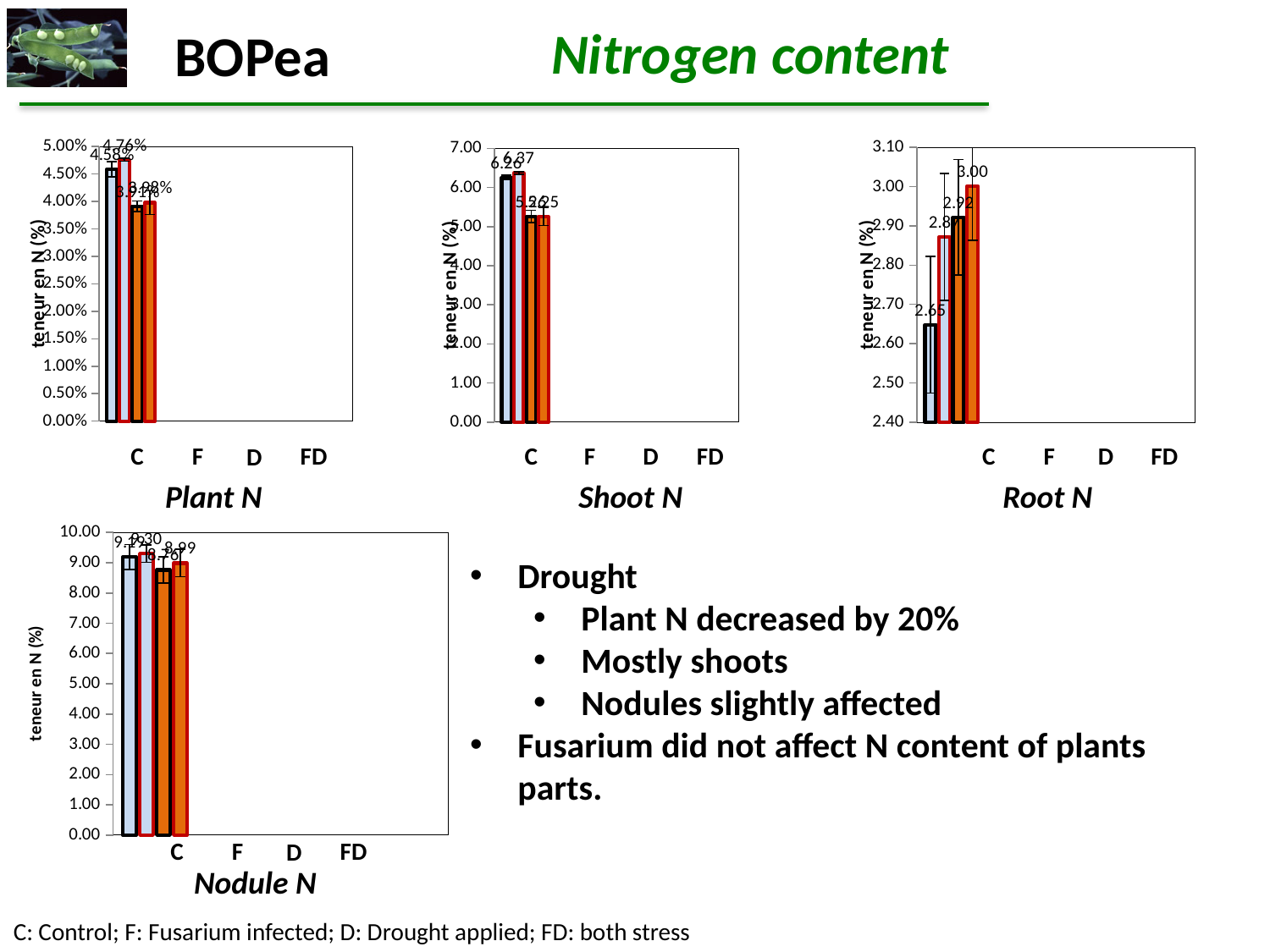
In the Root N chart, which treatment has the lowest nitrogen content? C In the Nodule N chart, what is the value for FD? 8.99 In the Plant N chart, what is the value for F? 4.76% In the Plant N chart, which is larger, the value for C or the value for D? C In the Root N chart, what is the value for C? 2.65 How many treatment categories are shown in the Plant N chart? 4 In the Root N chart, what is the value for FD? 3.00 What kind of chart is the Nodule N chart? bar chart In the Shoot N chart, is the value for D greater or less than 6.00? less In the Root N chart, what is the difference between the FD value and the C value? 0.35 In the Root N chart, which treatment has the highest nitrogen content? FD In the Shoot N chart, what is the value for F? 6.37